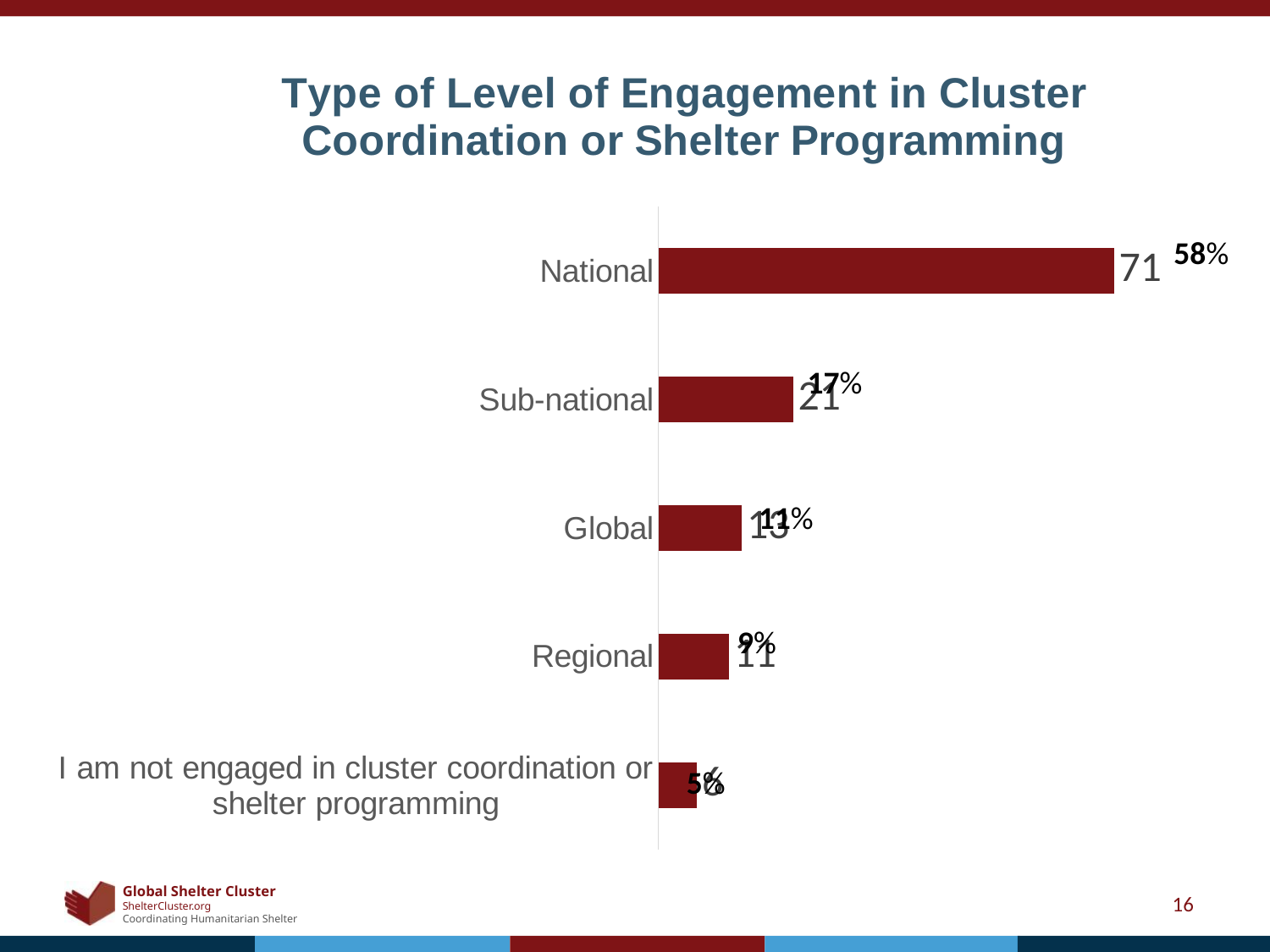
What is the difference in percentage between National and Sub-national? 41% What kind of chart is shown on the slide? bar chart What is the count value shown for National? 71 What is the title of the chart? Type of Level of Engagement in Cluster Coordination or Shelter Programming Which category has the highest value? National What colour are the bars in the chart? dark red Which has a larger value, Regional or National? National What percentage is shown for Sub-national? 17% What percentage is shown for National? 58% Which category has the lowest value? I am not engaged in cluster coordination or shelter programming Which has a larger value, Sub-national or Global? Sub-national How many categories are shown in the chart? 5